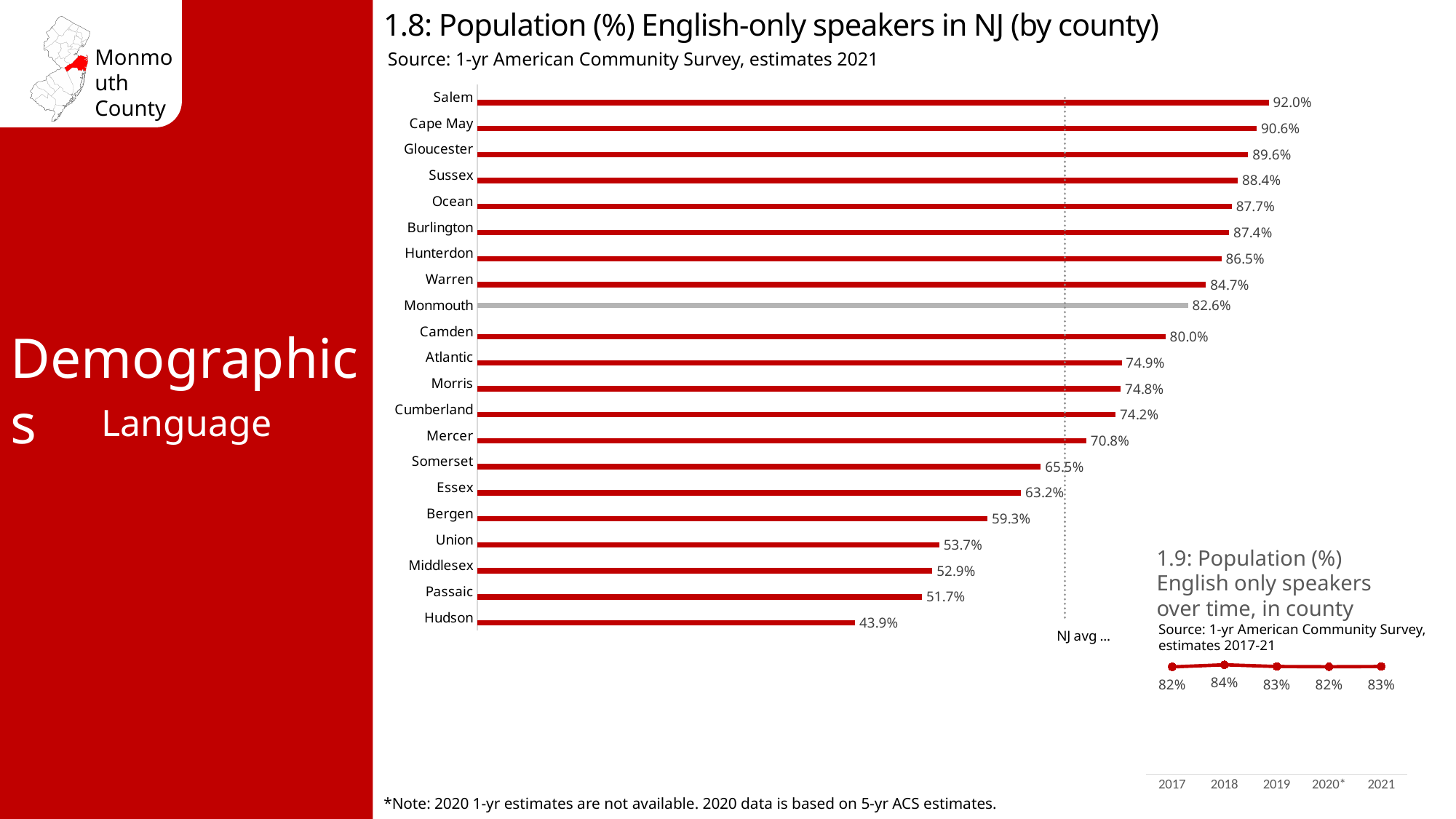
What kind of chart is chart 1.8? Bar chart In chart 1.8, how many counties are plotted? 21 In chart 1.8, what is the value for Hudson? 43.9% In chart 1.9, how many years are plotted? 5 In chart 1.8, which is larger, the value for Bergen or the value for Union? Bergen What kind of chart is chart 1.9? Line chart In chart 1.8, which county's bar is shown in grey instead of red? Monmouth In chart 1.8, what is the difference between the values for Salem and Hudson? 48.1% In chart 1.8, which county has the highest percentage of English-only speakers? Salem In chart 1.8, which county has the lowest percentage of English-only speakers? Hudson In chart 1.8, what is the value for Monmouth? 82.6% In chart 1.9, what is the value for 2018? 84%